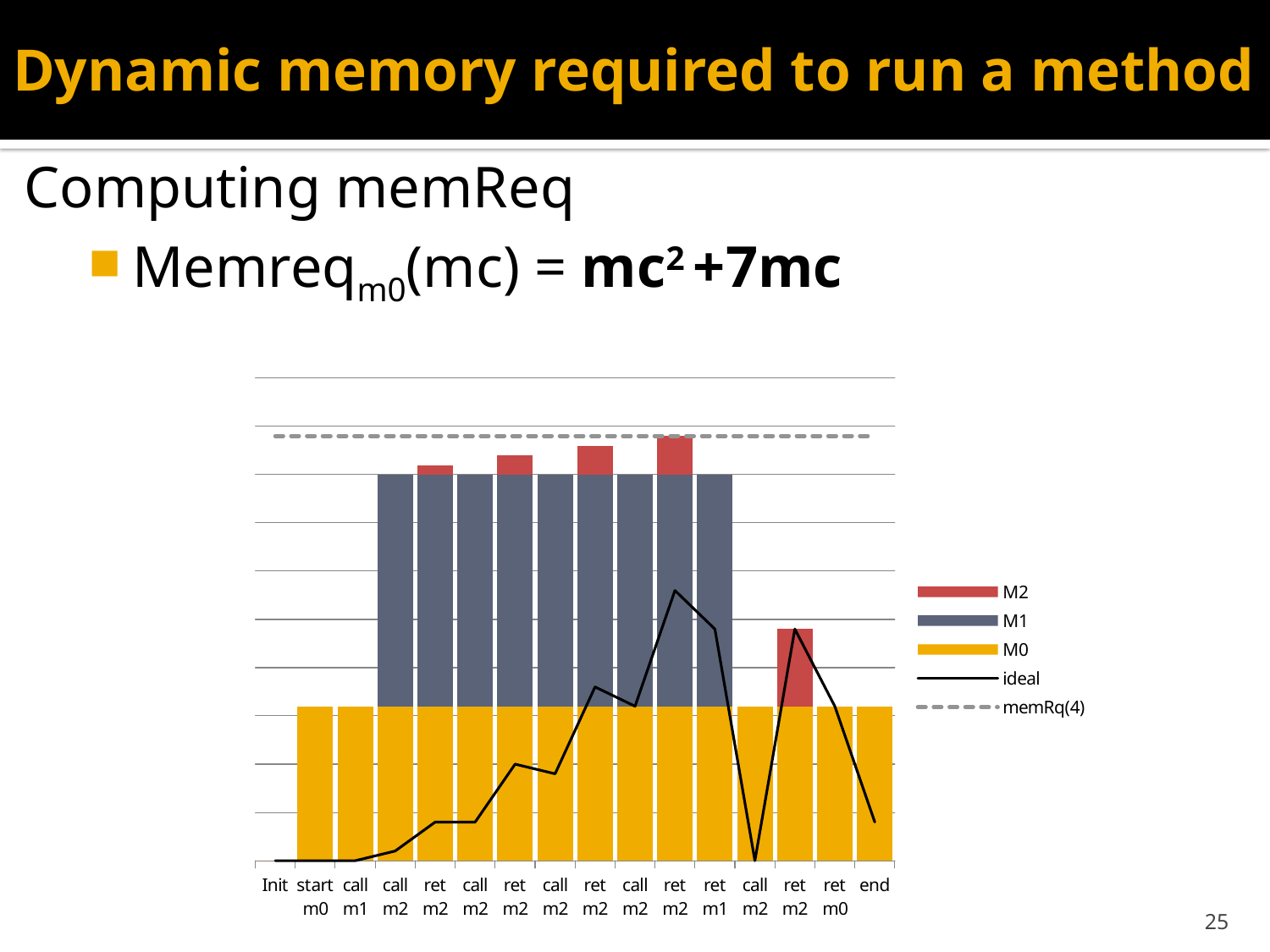
How many categories are shown along the x axis of the chart? 16 Does the 'ideal' line rise or fall from 'ret m1' to the following 'call m2'? fall Which is taller, the bar for 'end' or the bar for 'ret m1'? ret m1 Which series appears in the bars for 'call m2' and 'ret m2' but not in the bar for 'start m0'? M1 Which legend entry is drawn as a grey dashed line? memRq(4) Does the 'ideal' line rise or fall from 'Init' to the first 'call m2'? rise Which category has no bar at all in the chart? Init Which series forms the bottom segment of the stacked bars? M0 Which is taller, the bar for 'ret m1' or the bar for 'ret m0'? ret m1 What kind of chart is shown on the slide? stacked bar chart with line series How many entries does the chart legend list? 5